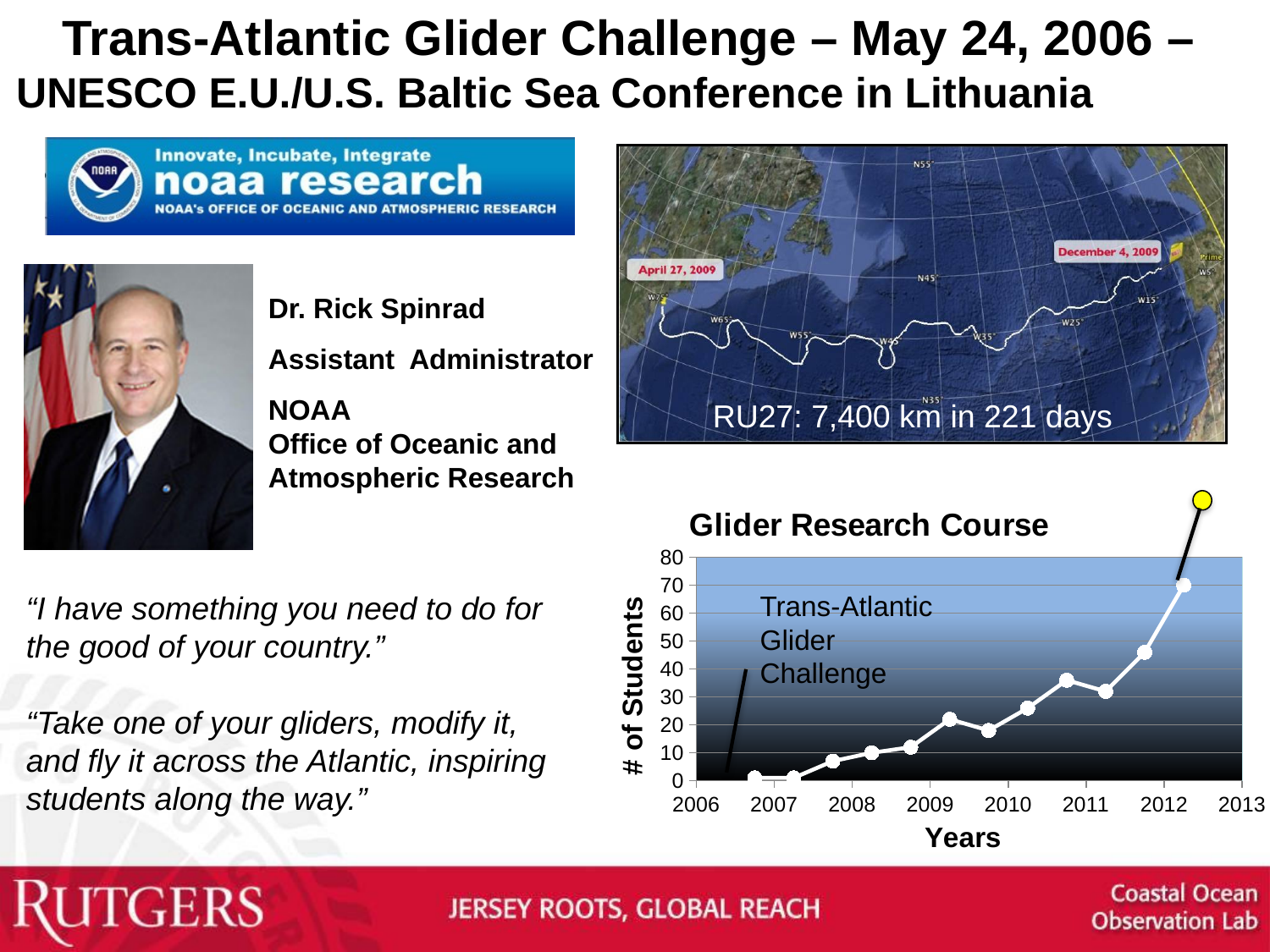
On the "Glider Research Course" chart, is the value of the point just after 2012 greater or less than 50? greater Overall, do the values on the "Glider Research Course" chart rise or fall from 2006 to 2013? rise What is the title of the chart on the slide? Glider Research Course On the "Glider Research Course" chart, is the value of the highest point greater or less than 80? less What is the label of the y axis on the "Glider Research Course" chart? # of Students On the "Glider Research Course" chart, which is larger: the value of the last plotted point or the value of the point just after 2011? the last plotted point On the "Glider Research Course" chart, is the value of the highest point greater or less than 60? greater What is the highest value shown on the y axis of the "Glider Research Course" chart? 80 What type of chart is the "Glider Research Course" chart? line chart On the "Glider Research Course" chart, in which year does the highest plotted point occur? 2012